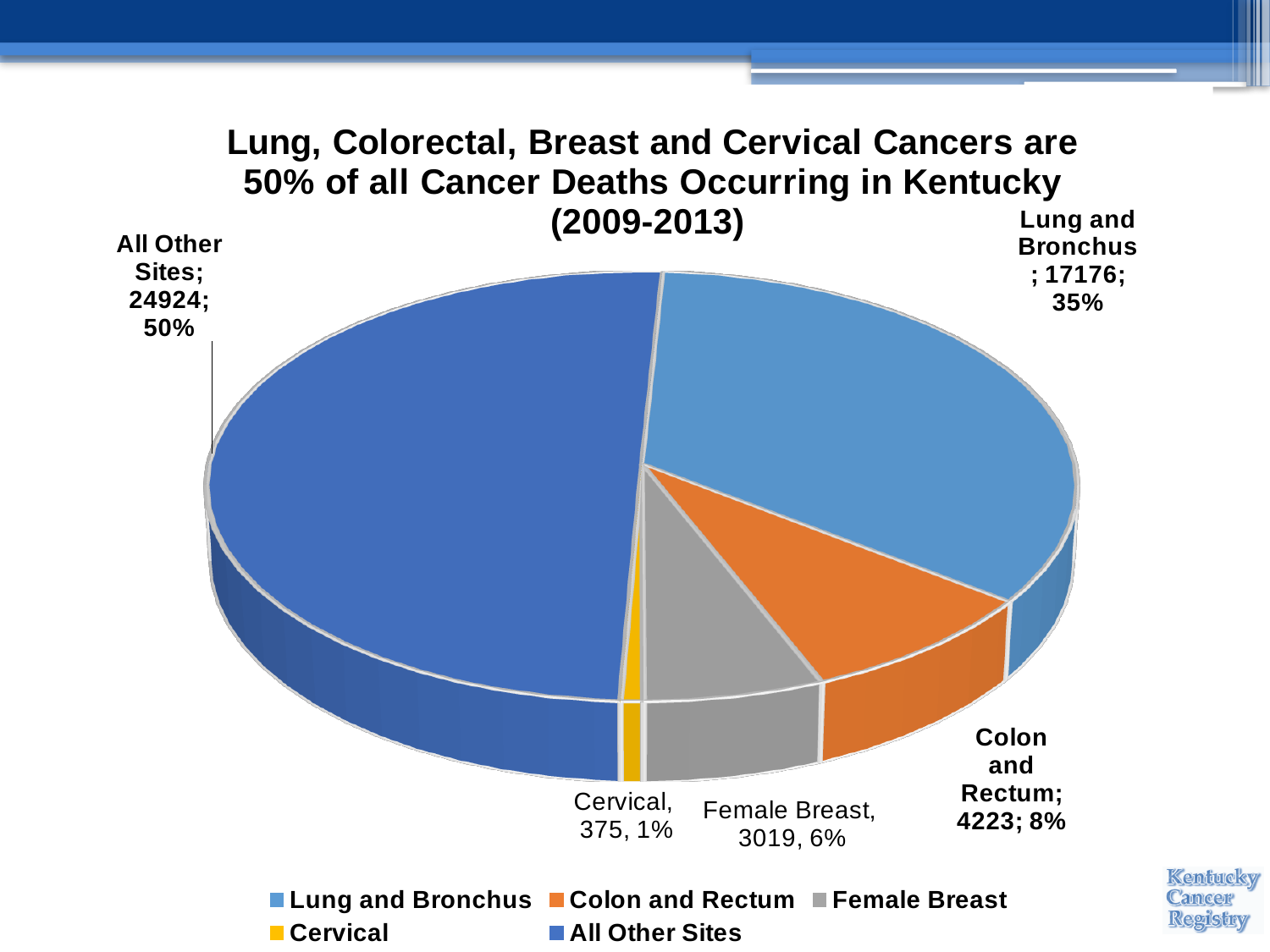
What percentage of cancer deaths is attributed to Colon and Rectum? 8% What colour is the Cervical slice in the chart? Yellow How many deaths are attributed to Female Breast cancer? 3019 Which has more deaths, Female Breast or Colon and Rectum? Colon and Rectum Which category has the largest slice of the pie? All Other Sites What share of the pie does All Other Sites represent? 50% What is the value for Cervical cancer deaths? 375 What is the difference in deaths between Lung and Bronchus and Colon and Rectum? 12953 How many categories are shown in the pie chart? 5 Which category has the smallest slice of the pie? Cervical What type of chart is shown on the slide? Pie chart How many deaths are attributed to Lung and Bronchus cancer? 17176